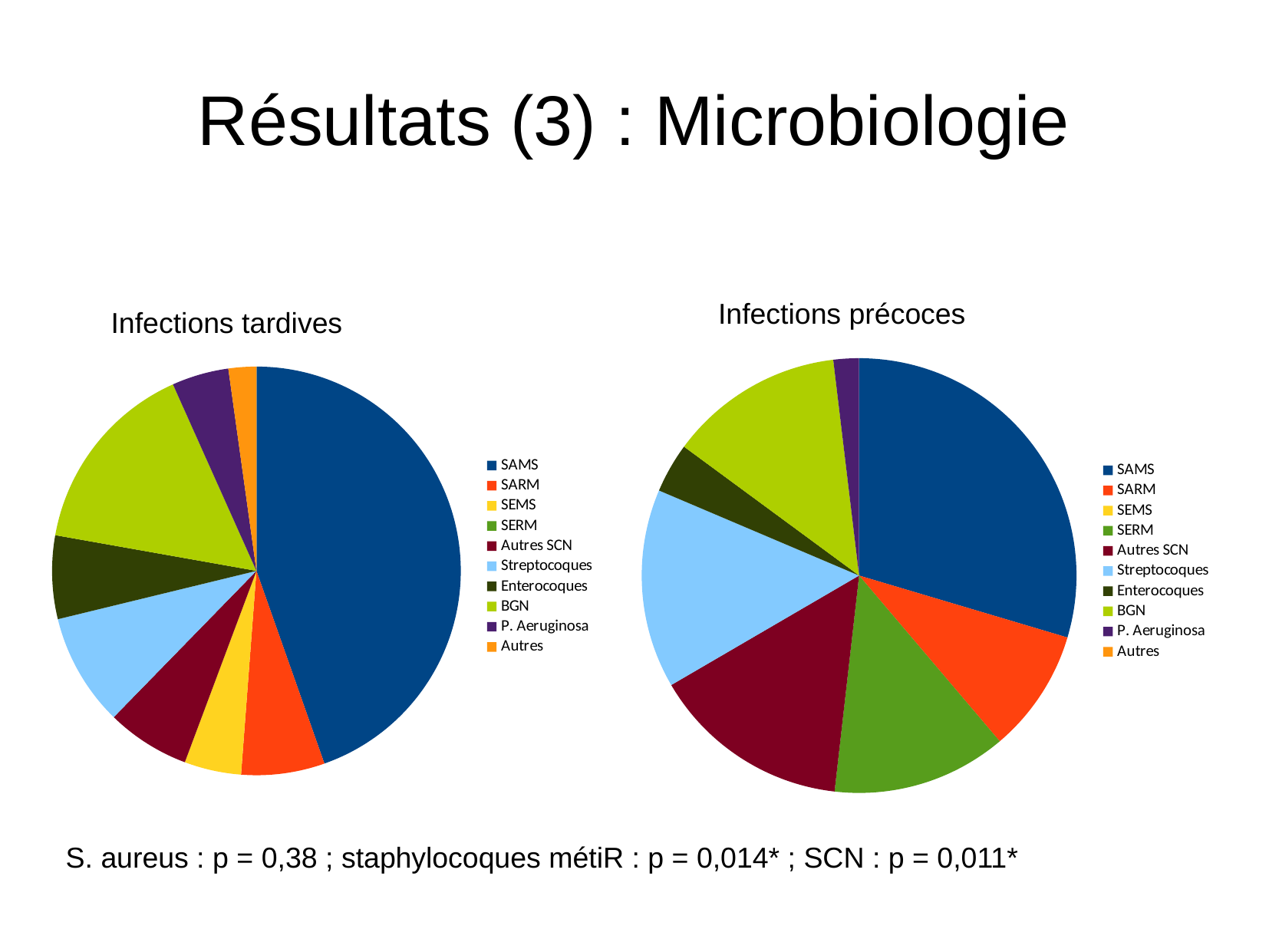
In the "Infections précoces" chart, which slice is larger, Streptocoques or Enterocoques? Streptocoques In the "Infections tardives" chart, which slice is larger, SARM or SEMS? SARM In the "Infections précoces" chart, which slice is larger, Autres SCN or SARM? Autres SCN In the "Infections précoces" chart, which category has the largest slice? SAMS What is the title of the pie chart on the left of the slide? Infections tardives How many entries does the legend of the "Infections précoces" chart list? 10 In the "Infections tardives" chart, which category has the largest slice? SAMS What kind of chart is the "Infections tardives" chart? pie chart How many categories does the legend of the "Infections tardives" chart list? 10 What kind of chart is the "Infections précoces" chart? pie chart In the "Infections tardives" chart, which category has the smallest slice? Autres